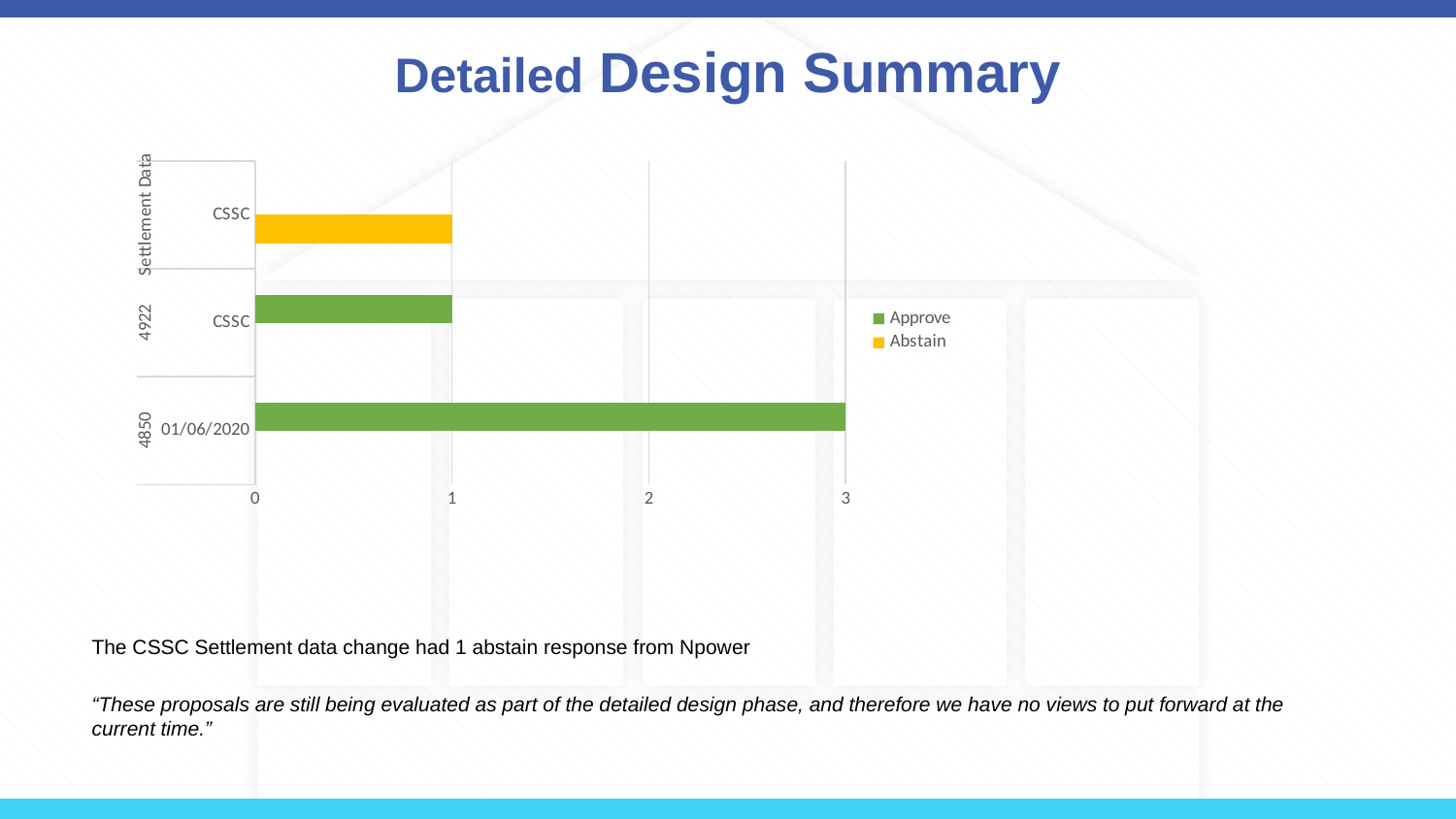
What is the Abstain value for the Settlement Data / CSSC category? 1 What is the Approve value for the 4850 / 01/06/2020 category? 3 How many bars are plotted in the chart? 3 Is the Approve value for 4850 / 01/06/2020 greater or less than 2? greater Which category has the longest bar in the chart? 4850 / 01/06/2020 What colour represents the Abstain series in the chart? Yellow Which is larger: the Approve value for 4850 / 01/06/2020 or the Abstain value for Settlement Data / CSSC? 4850 / 01/06/2020 Approve What is the Approve value for the 4922 / CSSC category? 1 What are the two series named in the chart legend? Approve and Abstain What kind of chart is shown on the slide? Bar chart What is the difference between the Approve value for 4850 / 01/06/2020 and the Approve value for 4922 / CSSC? 2 How many series does the chart legend list? 2